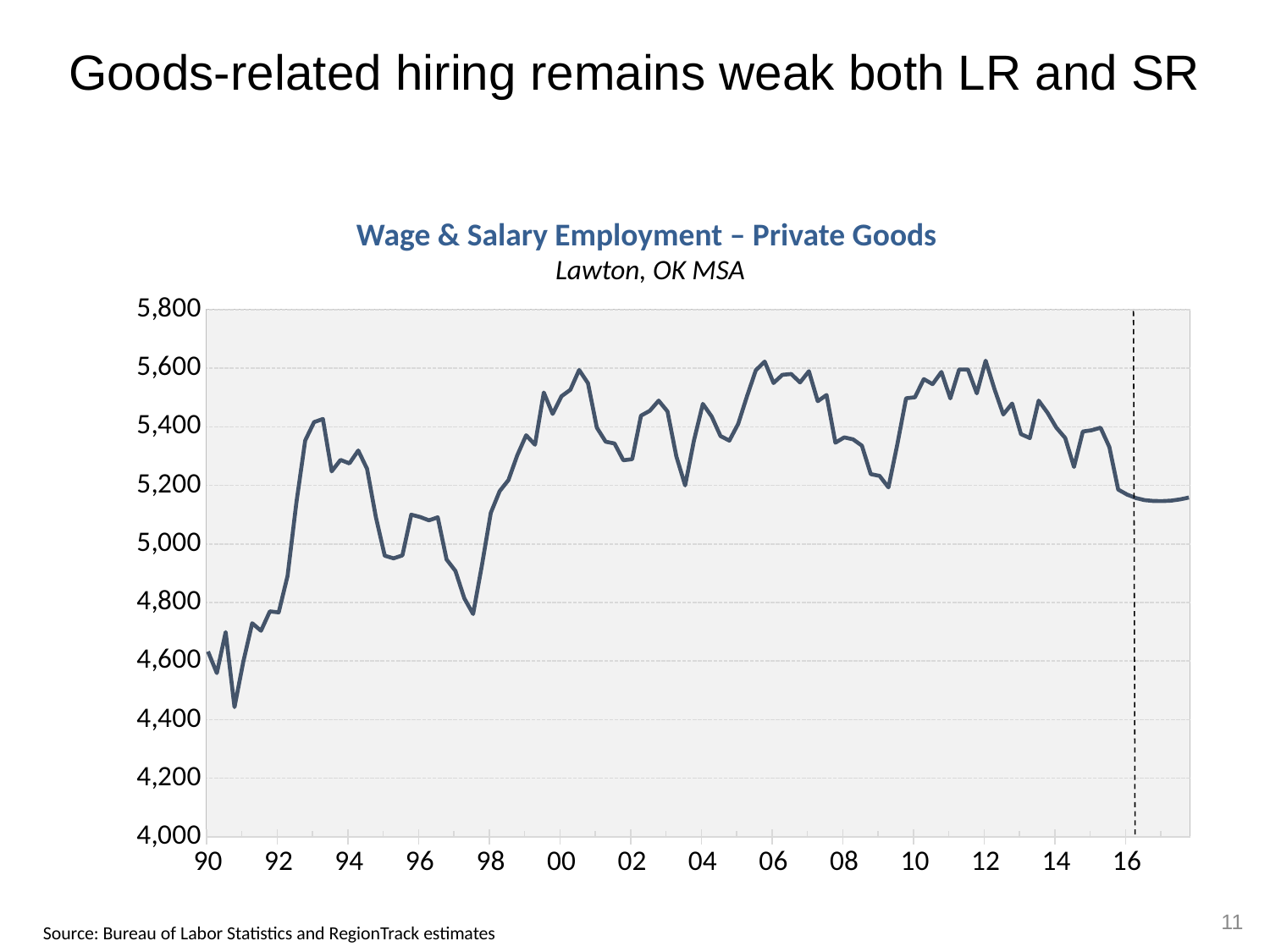
Is the value around 2016 greater or less than 5,400? less Does the line rise or fall between 1990 and 1993? rise What is the title of the chart? Wage & Salary Employment – Private Goods What kind of chart is shown on the slide? line chart Is the value around 1994 greater or less than 5,000? greater In which year does the line reach its lowest point? 1990 Does the line rise or fall between 2014 and 2016? fall Is the value around 2012 greater or less than 5,400? greater Which metropolitan area does the chart cover, according to its subtitle? Lawton, OK MSA How many year labels are shown on the x axis? 14